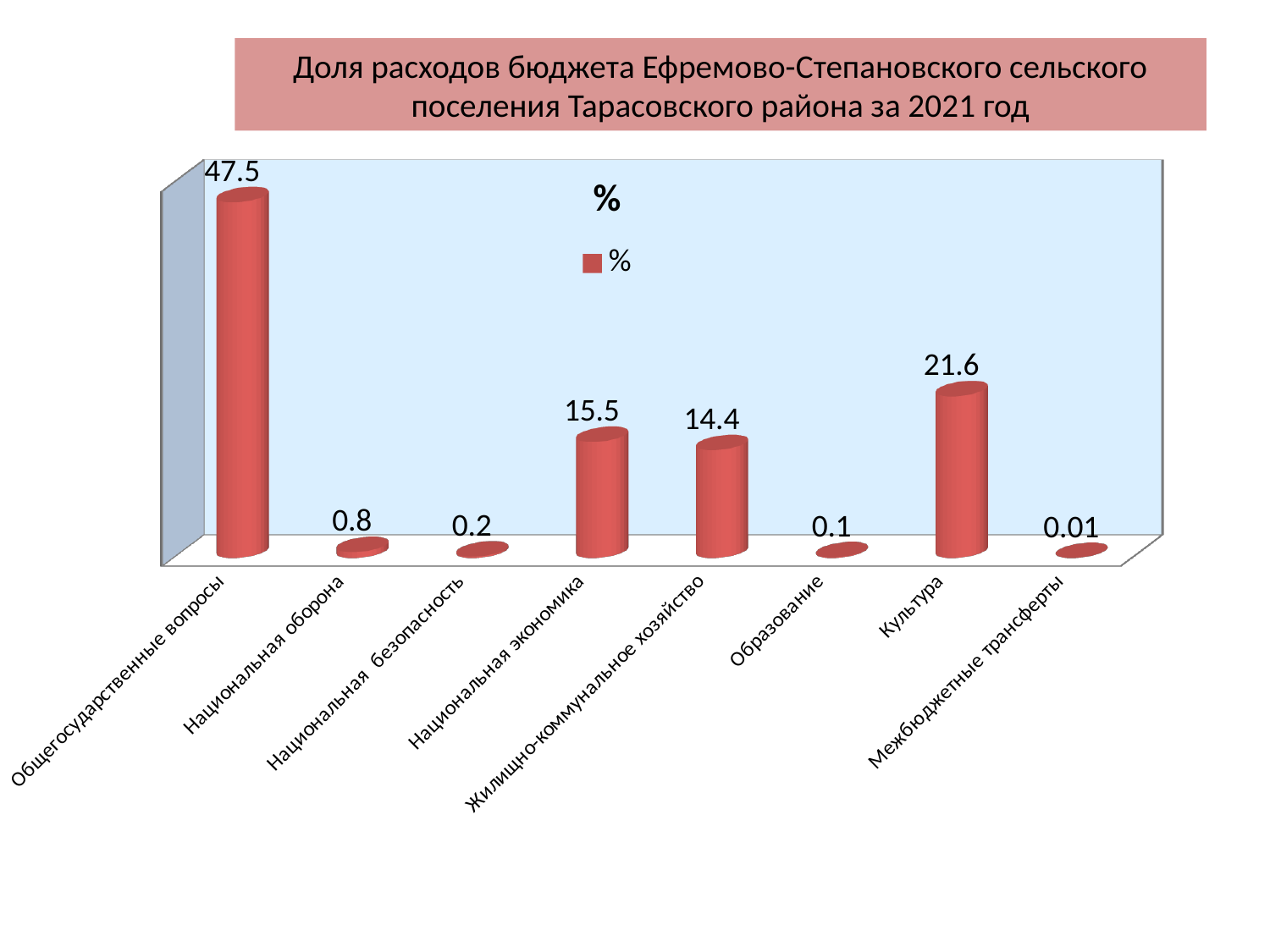
What is the value for Культура? 21.6 How many series does the legend list? 1 What kind of chart is shown on the slide? bar chart What is the value for Межбюджетные трансферты? 0.01 What is the value for Общегосударственные вопросы? 47.5 Which category has the highest value? Общегосударственные вопросы What is the difference between the values for Общегосударственные вопросы and Культура? 25.9 What is the legend entry shown on the chart? % How many categories are shown on the x axis? 8 Which category has the lowest value? Межбюджетные трансферты What is the value for Жилищно-коммунальное хозяйство? 14.4 Which is larger, the value for Национальная экономика or the value for Жилищно-коммунальное хозяйство? Национальная экономика